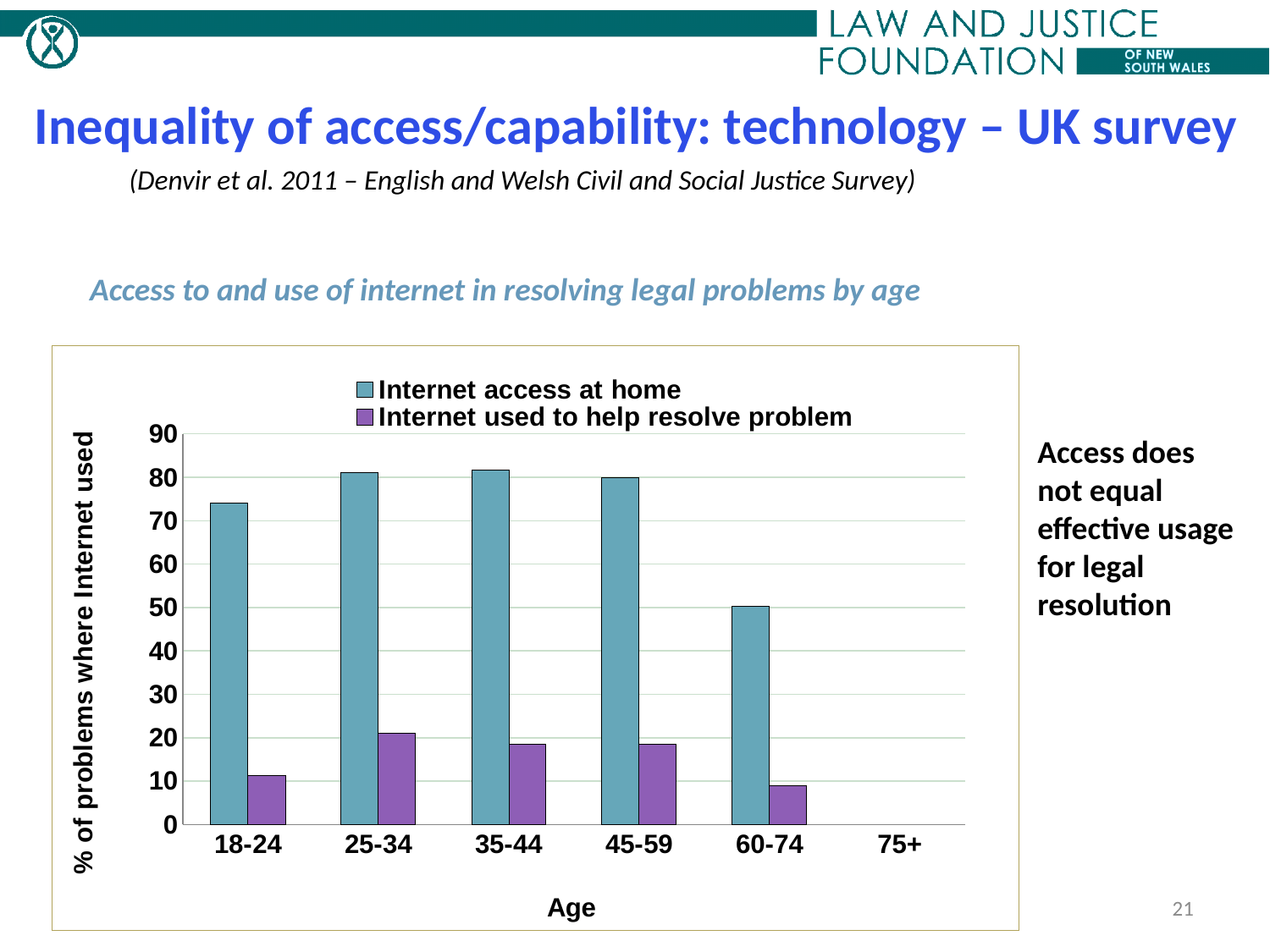
Which is larger: 'Internet used to help resolve problem' for the 18-24 age group or for the 25-34 age group? 25-34 What is the title of the y axis of the chart? % of problems where Internet used How many series does the chart legend list? 2 Is the value for 'Internet access at home' for the 18-24 age group greater or less than 70? greater Which age group has the highest value for 'Internet used to help resolve problem'? 25-34 Which is larger: 'Internet access at home' for the 45-59 age group or for the 60-74 age group? 45-59 Is the value for 'Internet access at home' for the 35-44 age group greater or less than 80? greater What kind of chart is shown on the slide? bar chart Is the value for 'Internet used to help resolve problem' for the 45-59 age group greater or less than 20? less How many age groups are shown on the x axis of the chart? 6 Does 'Internet access at home' rise or fall from the 45-59 age group to the 60-74 age group? fall